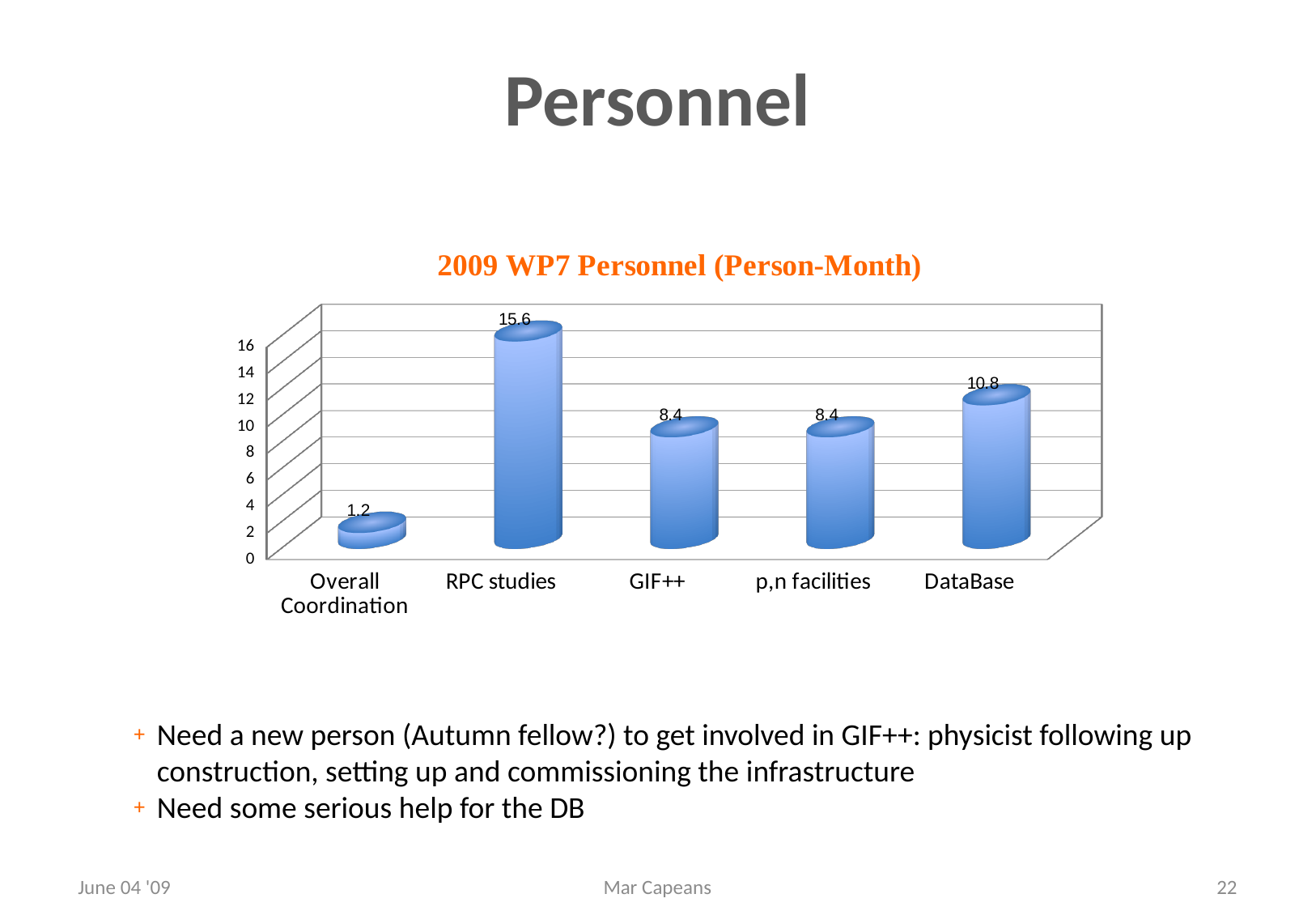
What is the value for RPC studies? 15.6 Which category has the lowest value? Overall Coordination What kind of chart is shown on the slide? Bar chart What is the difference between the values for RPC studies and DataBase? 4.8 How many categories are shown on the x axis? 5 Which category has the highest value? RPC studies Which is larger, the value for DataBase or the value for p,n facilities? DataBase What is the total of the values for GIF++ and p,n facilities? 16.8 What is the title of the chart? 2009 WP7 Personnel (Person-Month) What is the value for GIF++? 8.4 What is the value for Overall Coordination? 1.2 What is the value for DataBase? 10.8